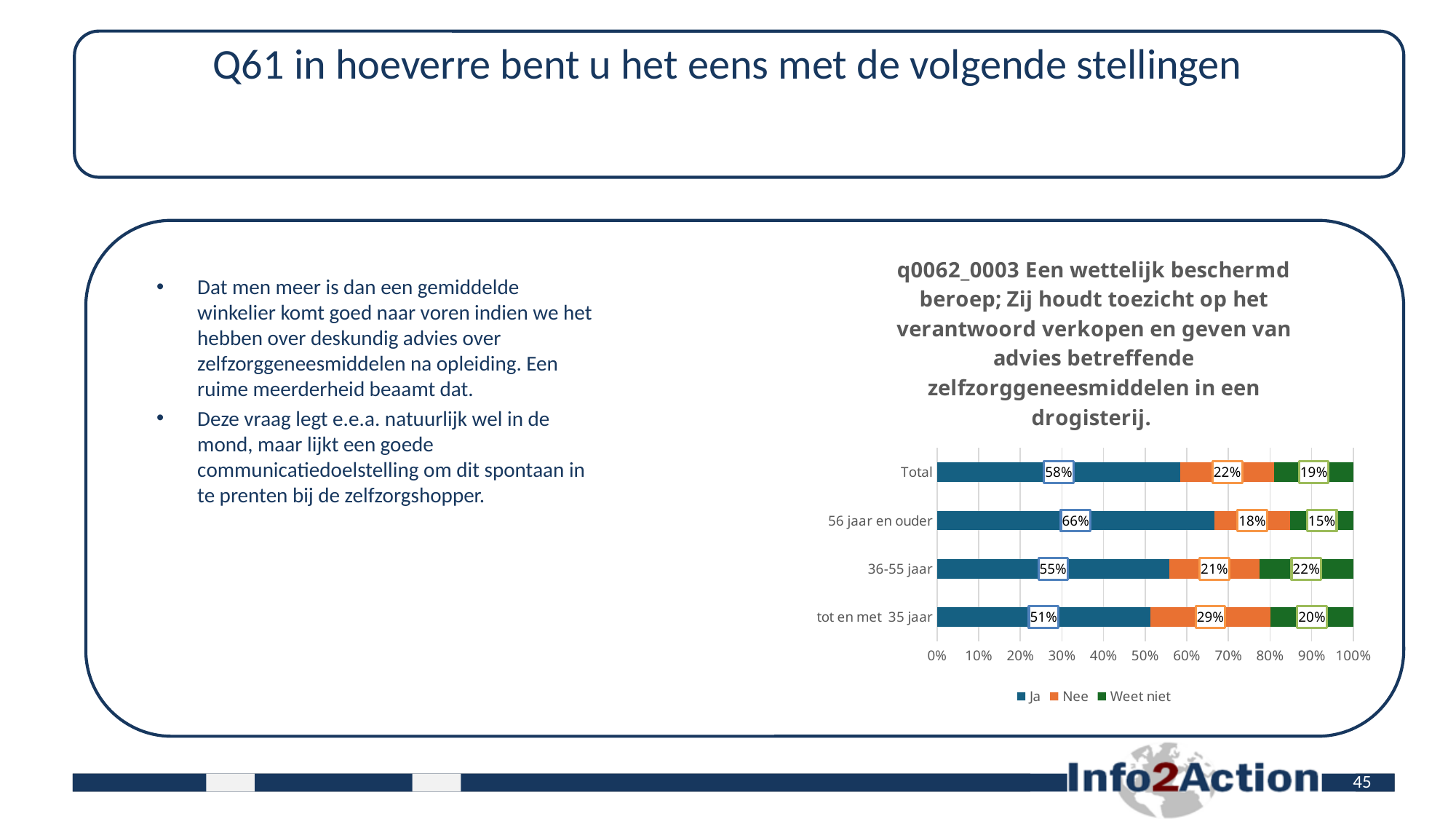
What kind of chart is shown on the slide? Stacked bar chart How many categories are shown on the vertical axis of the chart? 4 What is the Weet niet value for the Total category? 19% Which category has the lowest Weet niet percentage? 56 jaar en ouder Which series is shown in orange in the chart? Nee What is the total of the Ja and Nee segments for the 36-55 jaar bar? 76% What is the difference in the Ja percentage between 56 jaar en ouder and tot en met 35 jaar? 15% How many series does the chart legend list? 3 Which is larger: the Nee value for 36-55 jaar or the Nee value for tot en met 35 jaar? tot en met 35 jaar Which age group has the highest Ja percentage? 56 jaar en ouder What percentage of respondents aged 56 jaar en ouder answered Ja? 66% What is the Nee value for the tot en met 35 jaar group? 29%